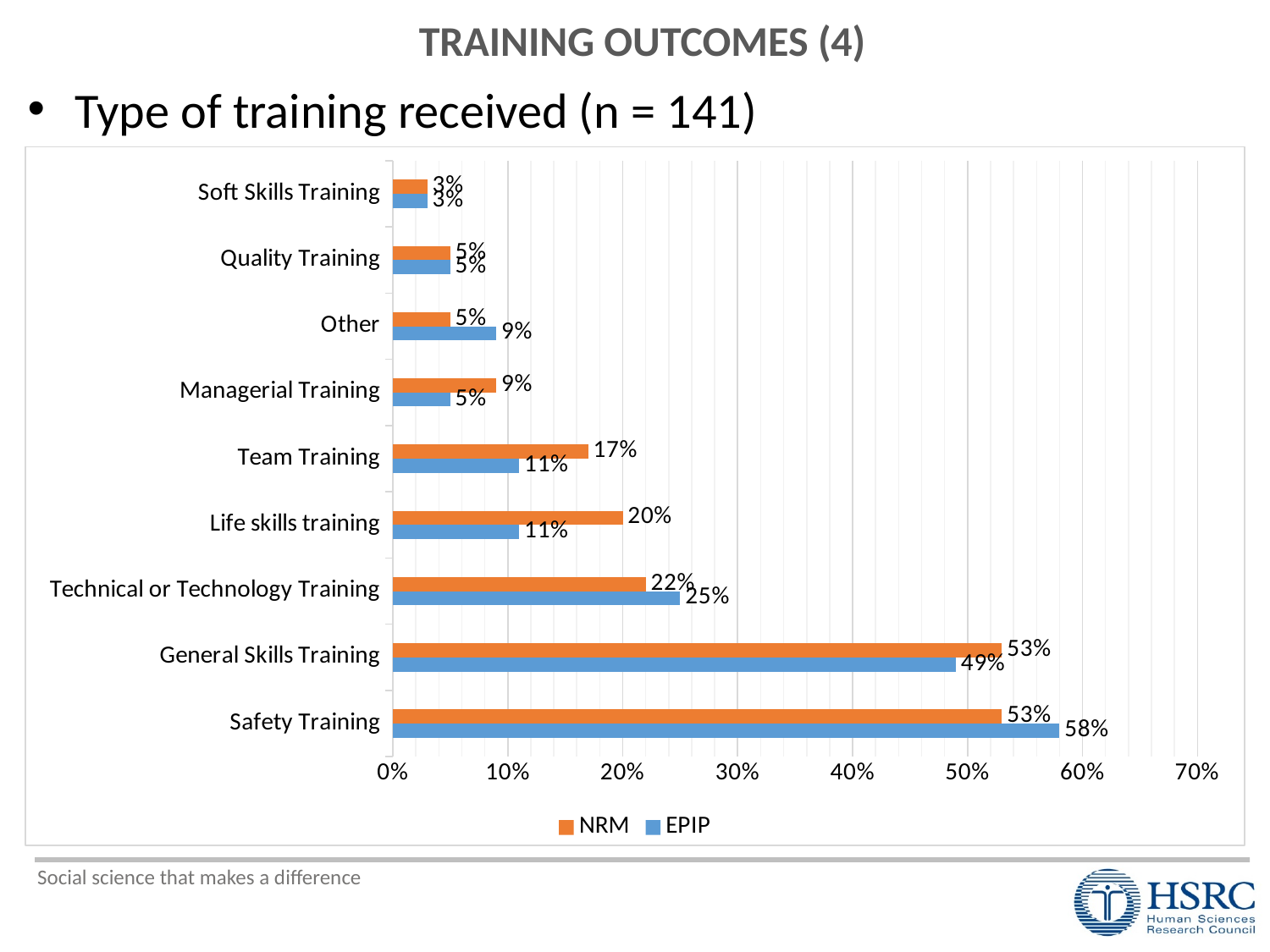
How many series does the legend list? 2 Which series is shown in orange in the legend? NRM What is the NRM value for Life skills training? 20% How many training categories are plotted on the chart? 9 Which category has the lowest NRM value? Soft Skills Training What is the EPIP value for Safety Training? 58% What is the difference between the EPIP and NRM values for Safety Training? 5% For Team Training, which series has the larger value, NRM or EPIP? NRM What kind of chart is shown on the slide? bar chart For Other, which series has the larger value, NRM or EPIP? EPIP What is the EPIP value for Technical or Technology Training? 25% Which category has the highest EPIP value? Safety Training